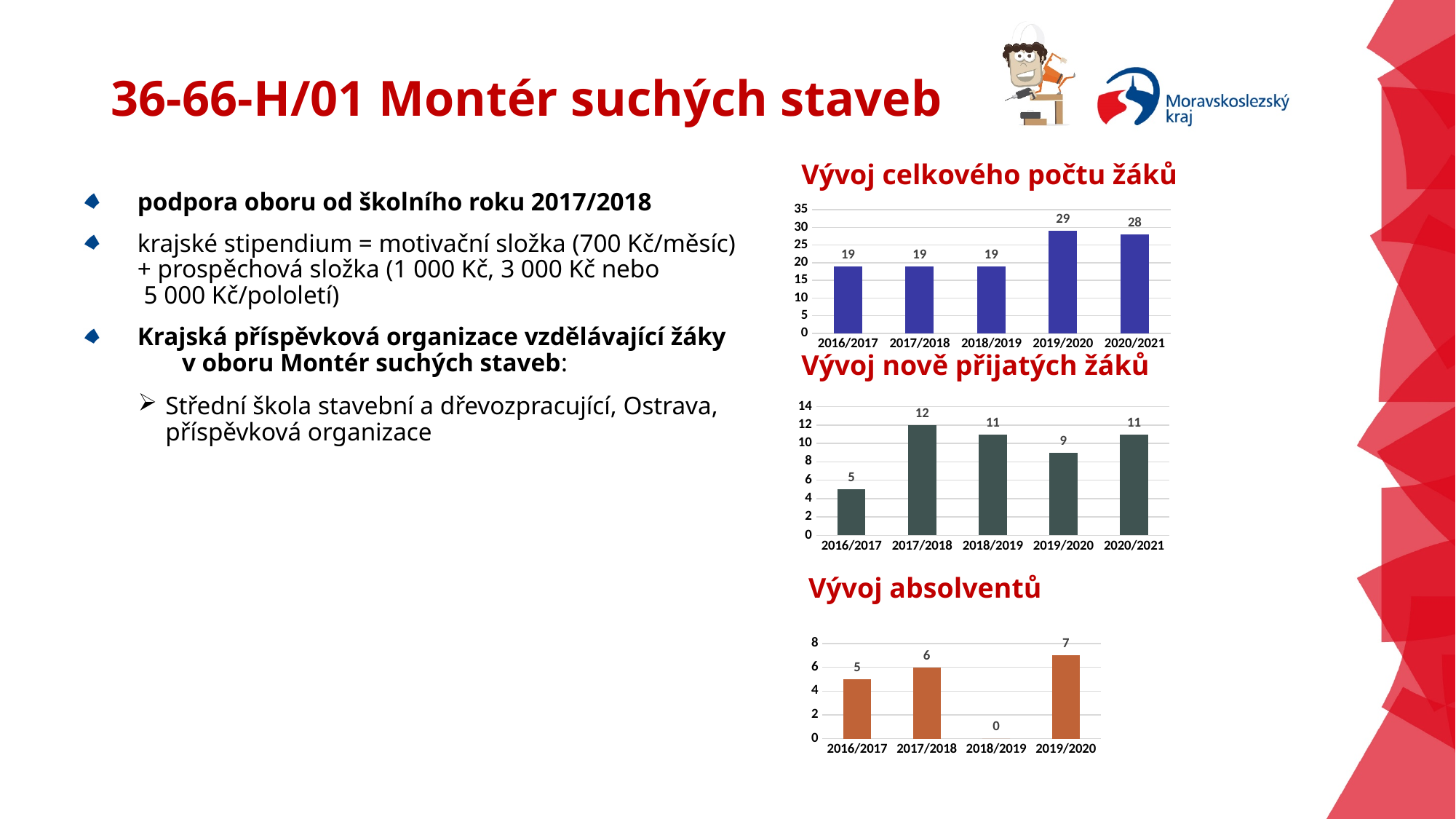
In the chart 'Vývoj celkového počtu žáků', which school year has the highest value? 2019/2020 In the chart 'Vývoj celkového počtu žáků', what is the difference between the values for 2019/2020 and 2018/2019? 10 In the chart 'Vývoj nově přijatých žáků', which is larger, the value for 2017/2018 or the value for 2019/2020? 2017/2018 What kind of chart is 'Vývoj absolventů'? bar chart In the chart 'Vývoj absolventů', which school year has the highest value? 2019/2020 In the chart 'Vývoj absolventů', what is the value for 2018/2019? 0 In the chart 'Vývoj nově přijatých žáků', what is the difference between the values for 2017/2018 and 2016/2017? 7 In the chart 'Vývoj absolventů', how many school years are shown on the x axis? 4 In the chart 'Vývoj nově přijatých žáků', what is the value for 2016/2017? 5 In the chart 'Vývoj celkového počtu žáků', what is the value for 2019/2020? 29 In the chart 'Vývoj celkového počtu žáků', how many school years are shown on the x axis? 5 In the chart 'Vývoj nově přijatých žáků', which school year has the lowest value? 2016/2017